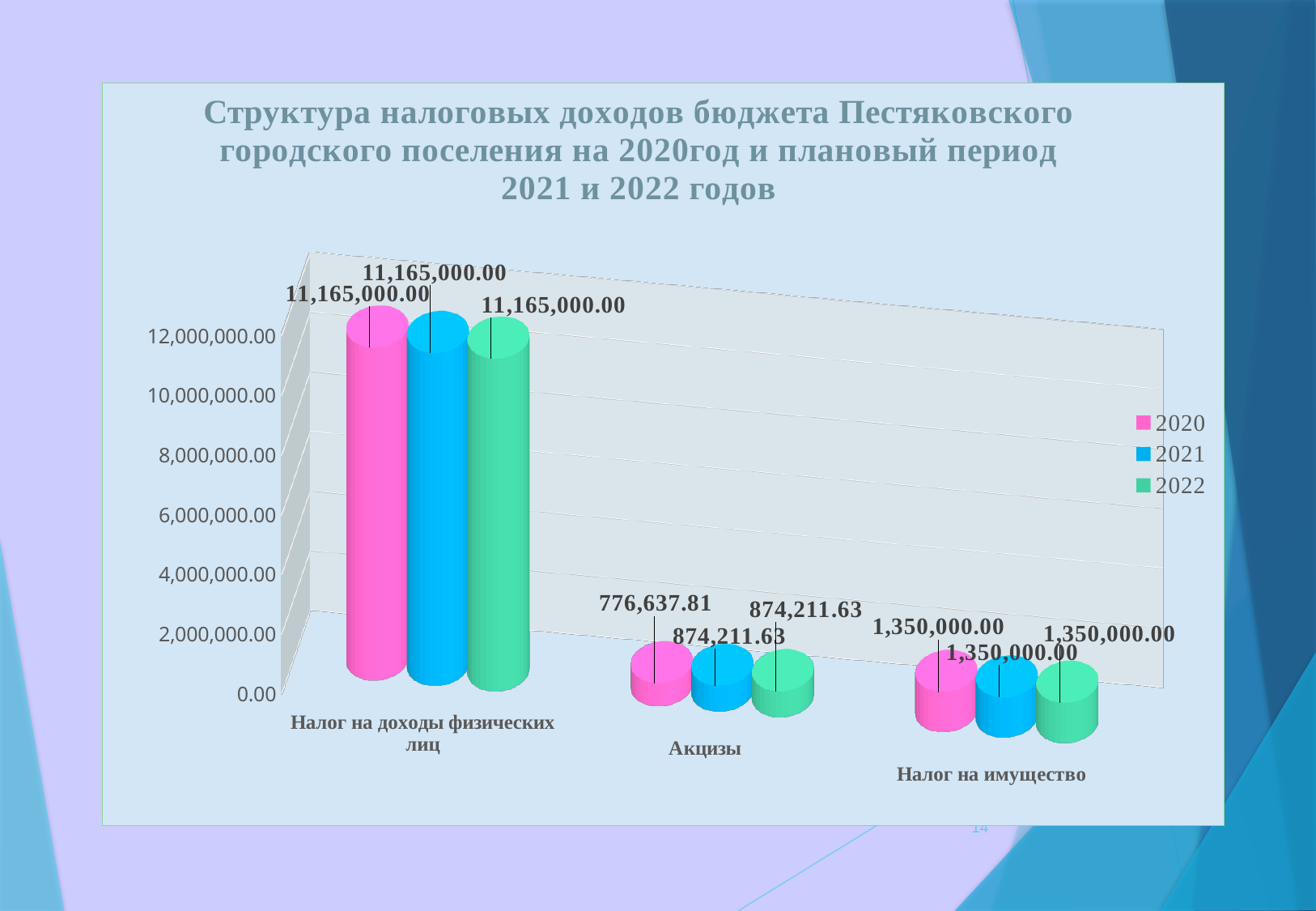
How many series does the legend list? 3 What is the value for Акцизы in 2020? 776,637.81 What is the value for Акцизы in 2021? 874,211.63 What is the difference between the 2021 and 2020 values for Акцизы? 97,573.82 What kind of chart is shown on the slide? bar chart Which category has the lowest value in 2022? Акцизы What is the value for Налог на имущество in 2021? 1,350,000.00 How many categories are shown on the x axis? 3 What is the value for Налог на доходы физических лиц in 2022? 11,165,000.00 Is the value for Налог на доходы физических лиц in 2021 greater or less than 10,000,000.00? greater Which is larger: the 2020 value for Налог на имущество or the 2020 value for Акцизы? Налог на имущество Which category has the highest value in 2020? Налог на доходы физических лиц